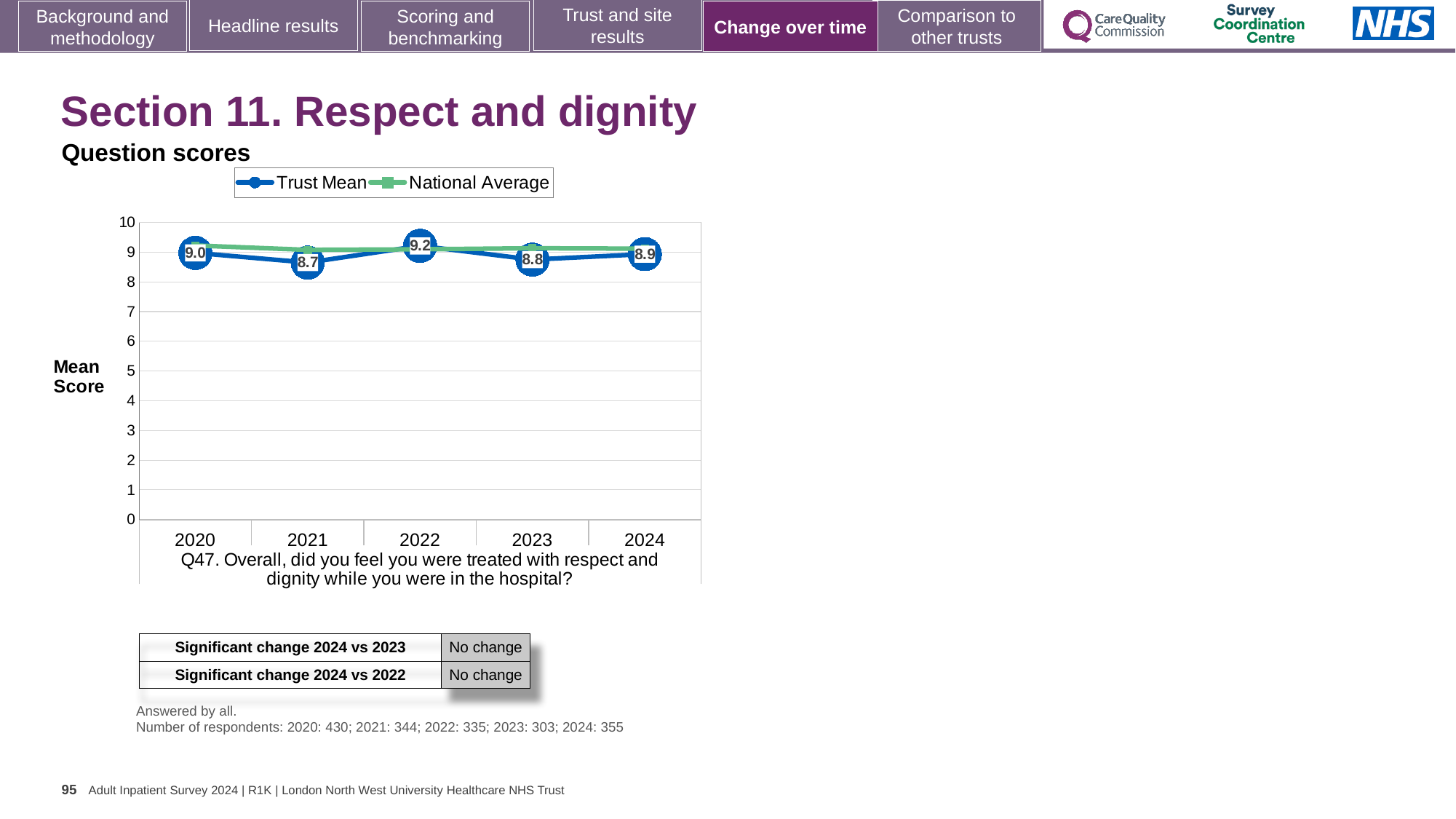
What is the Trust Mean score for 2021? 8.7 In which year is the Trust Mean score highest? 2022 Which year has the larger Trust Mean score, 2020 or 2023? 2020 How many years are plotted on the x axis? 5 What kind of chart is shown on the slide? Line chart What is the Trust Mean score for 2024? 8.9 How many series does the legend list? 2 What is the difference between the Trust Mean scores for 2022 and 2021? 0.5 Does the Trust Mean score rise or fall from 2020 to 2021? Fall In which year is the Trust Mean score lowest? 2021 Is the National Average value for 2020 greater or less than 8? greater What is the Trust Mean score for 2022? 9.2